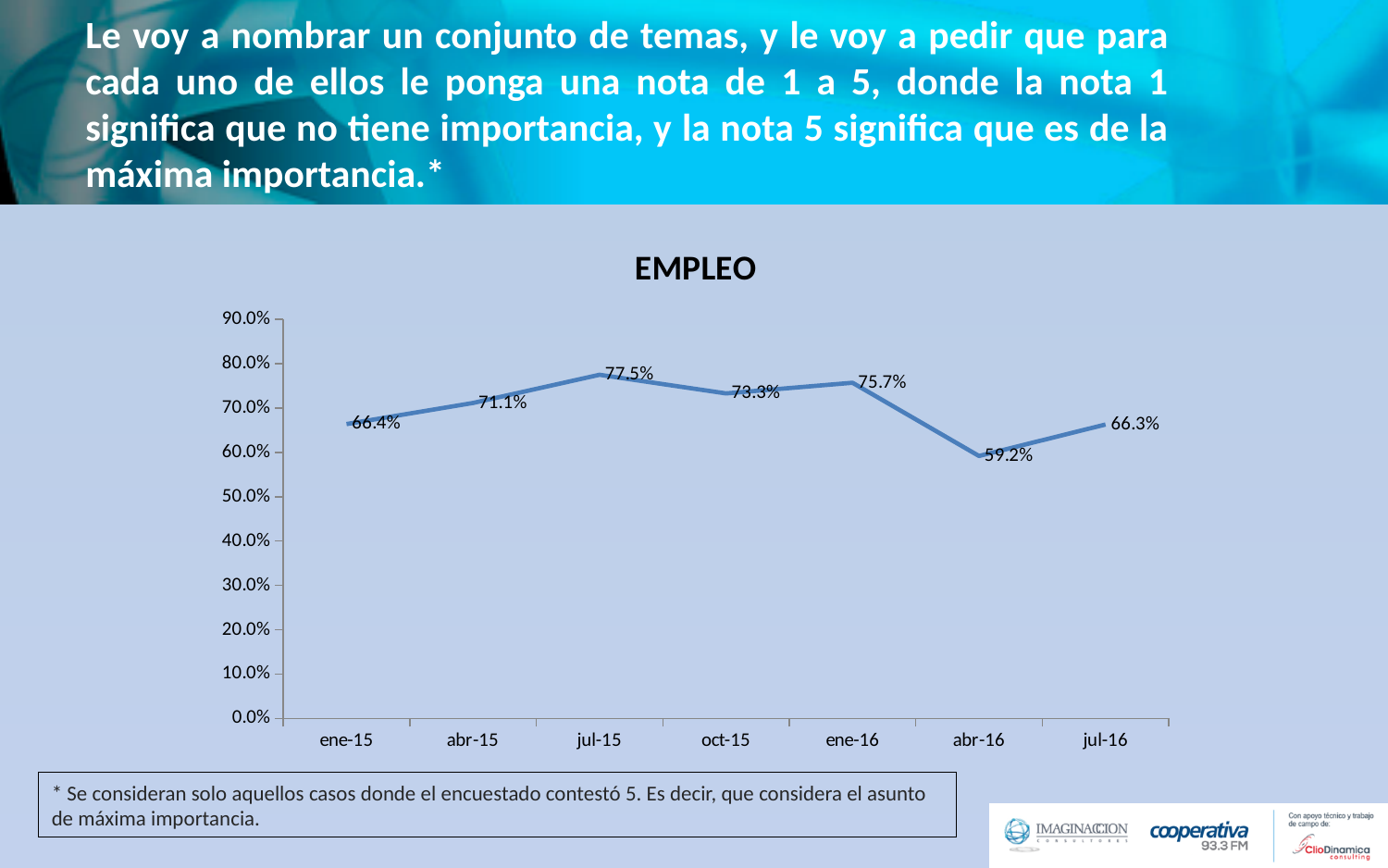
What is the value for jul-15 in the EMPLEO chart? 77.5% What is the difference between the values for jul-15 and abr-16 in the EMPLEO chart? 18.3% What is the title of the chart on the slide? EMPLEO Does the value in the EMPLEO chart rise or fall from ene-16 to abr-16? fall What is the value for ene-15 in the EMPLEO chart? 66.4% Is the value for abr-16 in the EMPLEO chart greater or less than 60.0%? less What is the value for abr-16 in the EMPLEO chart? 59.2% Which period has the highest value in the EMPLEO chart? jul-15 How many periods are plotted on the x axis of the EMPLEO chart? 7 Which is larger in the EMPLEO chart, the value for oct-15 or the value for ene-16? ene-16 Which period has the lowest value in the EMPLEO chart? abr-16 What kind of chart is the EMPLEO chart? line chart